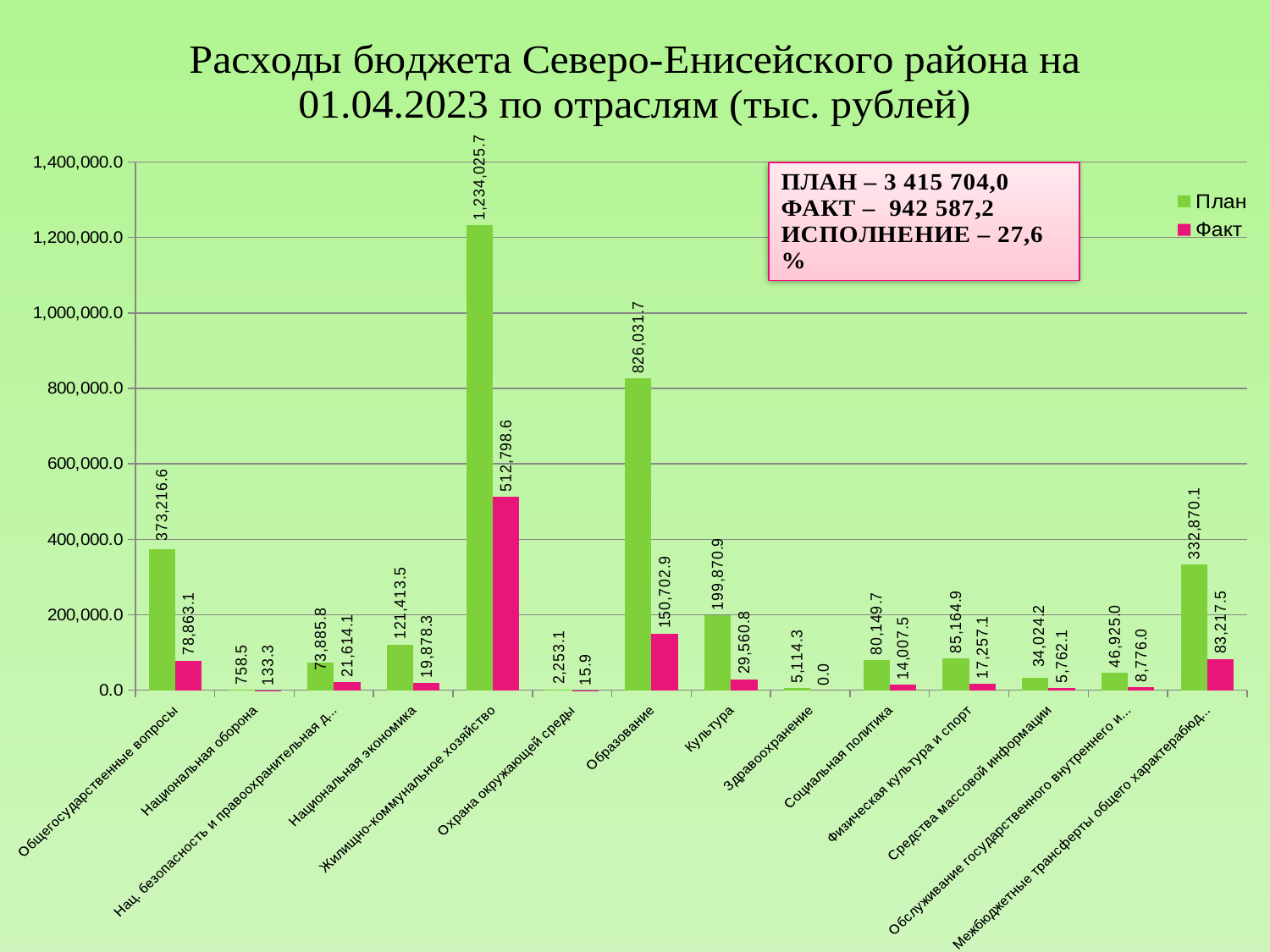
What is the План value for Национальная оборона? 758.5 What is the Факт value for Жилищно-коммунальное хозяйство? 512,798.6 Which category has the lowest Факт value? Здравоохранение What is the План value for Образование? 826,031.7 What kind of chart is shown on the slide? Bar chart Which is larger, the План value for Общегосударственные вопросы or the План value for Межбюджетные трансферты общего характера? Общегосударственные вопросы What are the two series named in the legend? План and Факт What is the Факт value for Культура? 29,560.8 How many categories are shown on the x axis? 14 What is the difference between the План and Факт values for Жилищно-коммунальное хозяйство? 721,227.1 How many series does the legend list? 2 Which category has the highest План value? Жилищно-коммунальное хозяйство